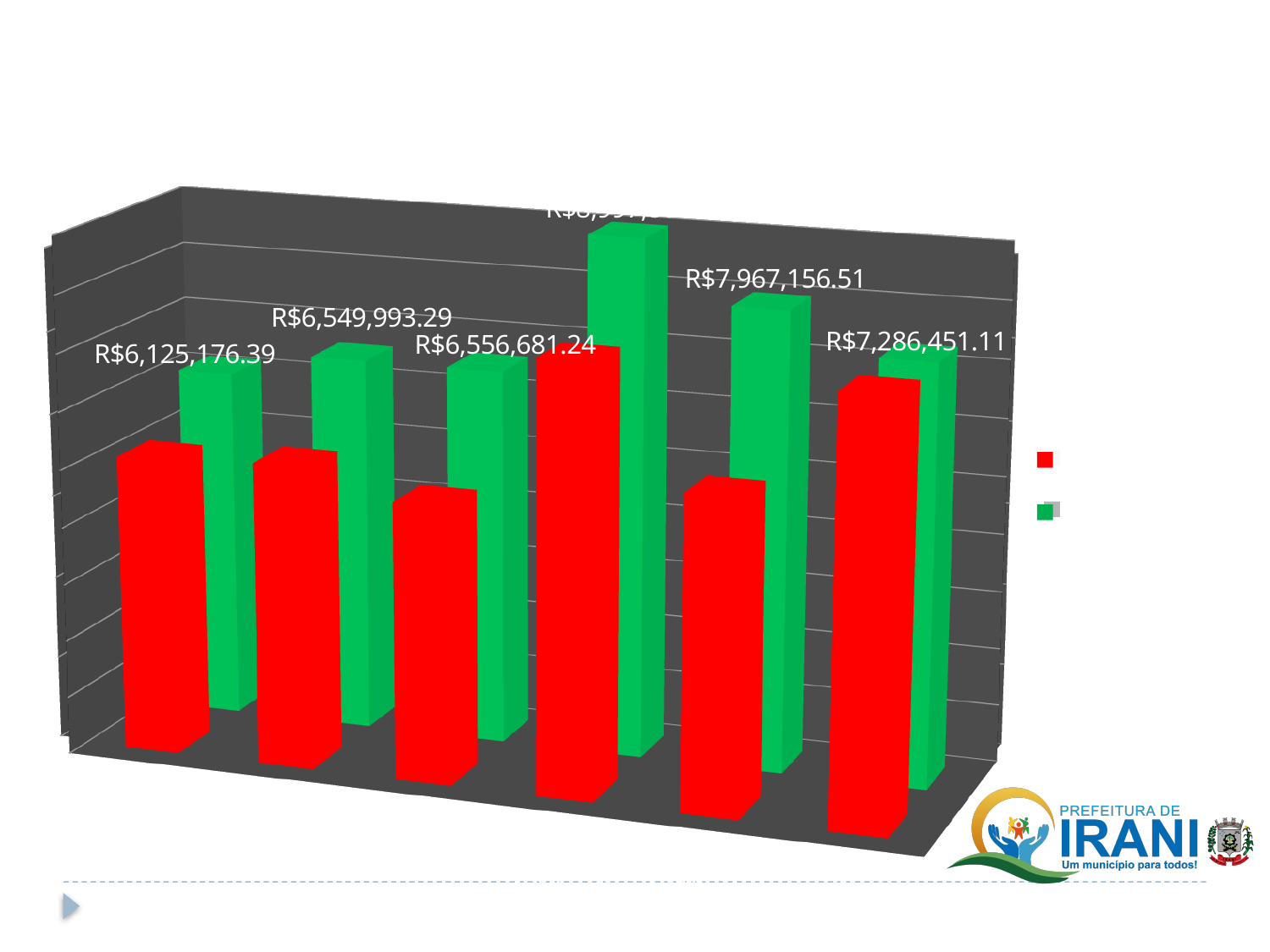
How many groups of bars are plotted in the chart? 6 In the fifth group from the left, which bar is taller, the red one or the green one? the green one How many series does the legend list? 2 What value is labelled on the green bar in the second group from the left? R$6,549,993.29 What kind of chart is shown on the slide? bar chart What value is labelled on the green bar in the third group from the left? R$6,556,681.24 Which group from the left has the tallest green bar? the fourth group What value is labelled on the green bar in the sixth group from the left? R$7,286,451.11 Which group from the left has the shortest red bar? the third group What value is labelled on the green bar in the fifth group from the left? R$7,967,156.51 What is the difference between the green bar values labelled in the fifth and sixth groups from the left? R$680,705.40 What value is labelled on the green bar in the first group from the left? R$6,125,176.39